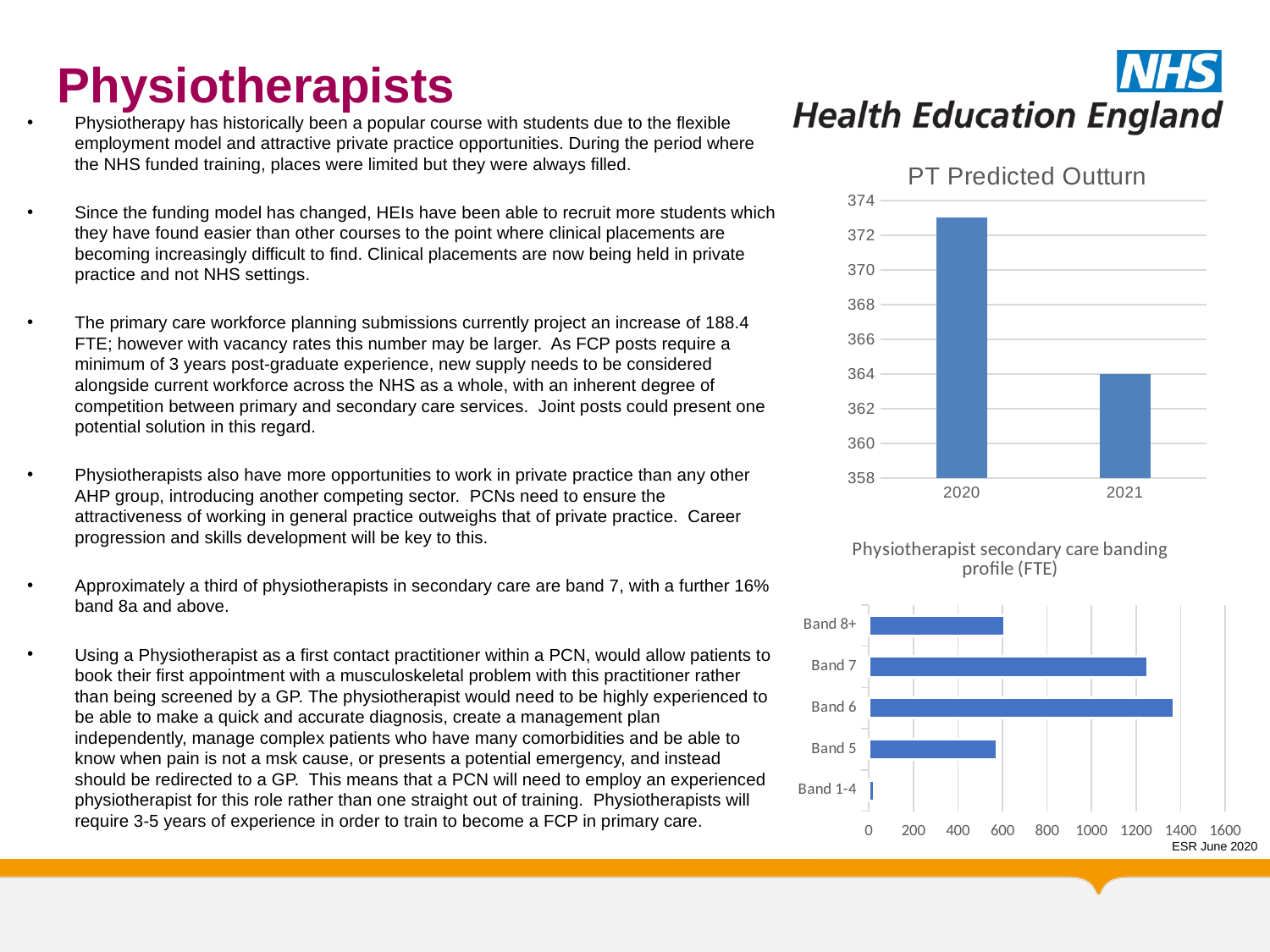
In the Physiotherapist secondary care banding profile (FTE) chart, which is larger, Band 7 or Band 5? Band 7 In the PT Predicted Outturn chart, what is the value for 2021? 364 In the PT Predicted Outturn chart, which year has the higher value? 2020 In the Physiotherapist secondary care banding profile (FTE) chart, is the value for Band 7 greater or less than 1200? greater In the PT Predicted Outturn chart, how many years are plotted? 2 In the Physiotherapist secondary care banding profile (FTE) chart, how many bands are shown? 5 In the PT Predicted Outturn chart, do the values rise or fall from 2020 to 2021? fall What kind of chart is the Physiotherapist secondary care banding profile (FTE) chart? bar chart In the Physiotherapist secondary care banding profile (FTE) chart, which band has the lowest value? Band 1-4 In the PT Predicted Outturn chart, is the value for 2020 greater or less than 372? greater In the Physiotherapist secondary care banding profile (FTE) chart, which band has the highest value? Band 6